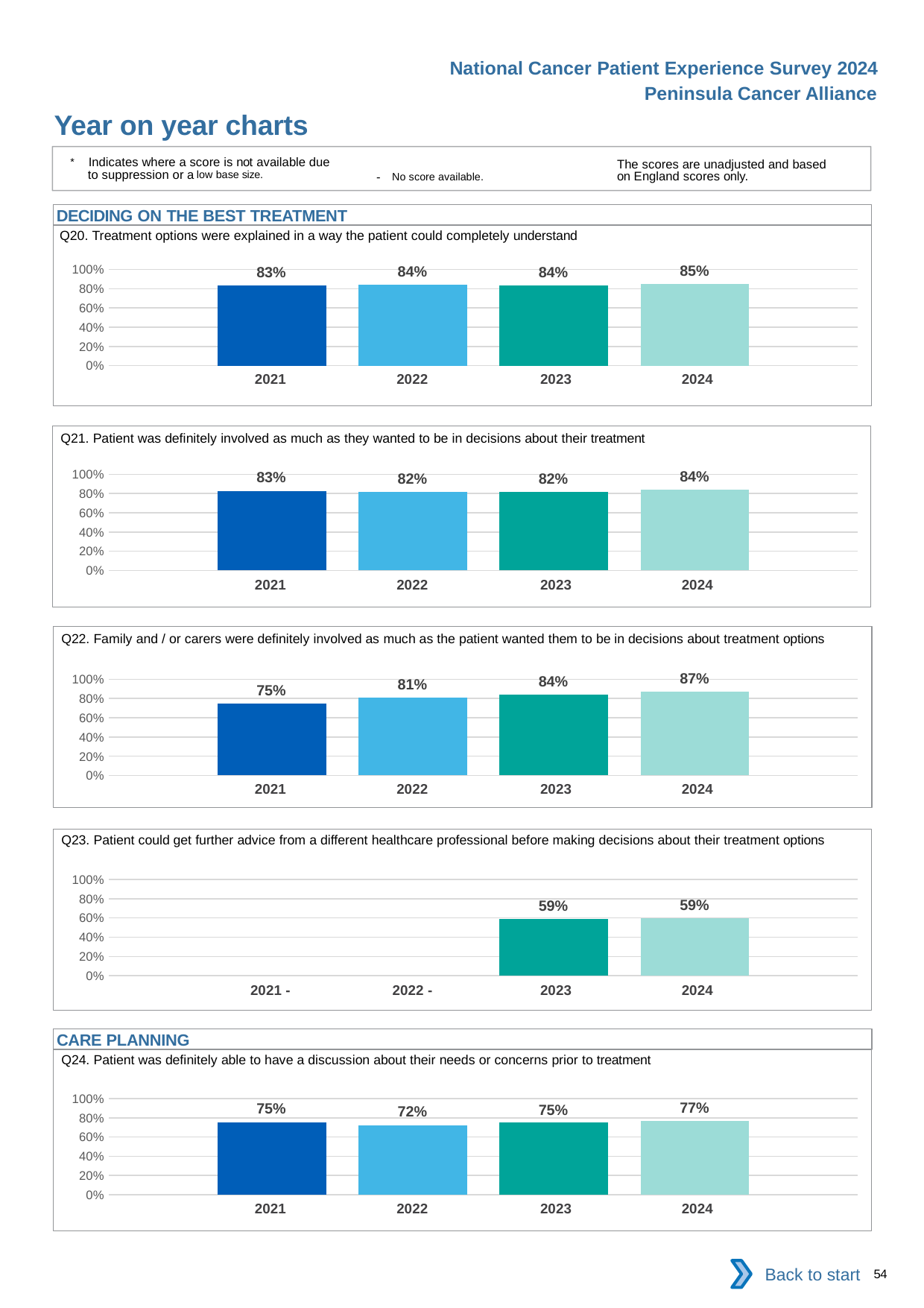
In the Q23 chart, how many years have a bar plotted? 2 In the Q21 chart, what is the value for 2022? 82% In the Q24 chart, which year has the lowest value? 2022 In the Q22 chart, which year has the lowest value? 2021 In the Q23 chart, what is the value for 2023? 59% In the Q20 chart, what is the value for 2021? 83% What kind of chart is the Q24 chart? bar chart In the Q24 chart, is the value for 2024 larger than the value for 2021? Yes In the Q20 chart, what is the value for 2024? 85% In the Q22 chart, do the values rise or fall from 2021 to 2024? rise In the Q22 chart, what is the difference between the 2024 and 2021 values? 12 percentage points In the Q21 chart, which year has the highest value? 2024